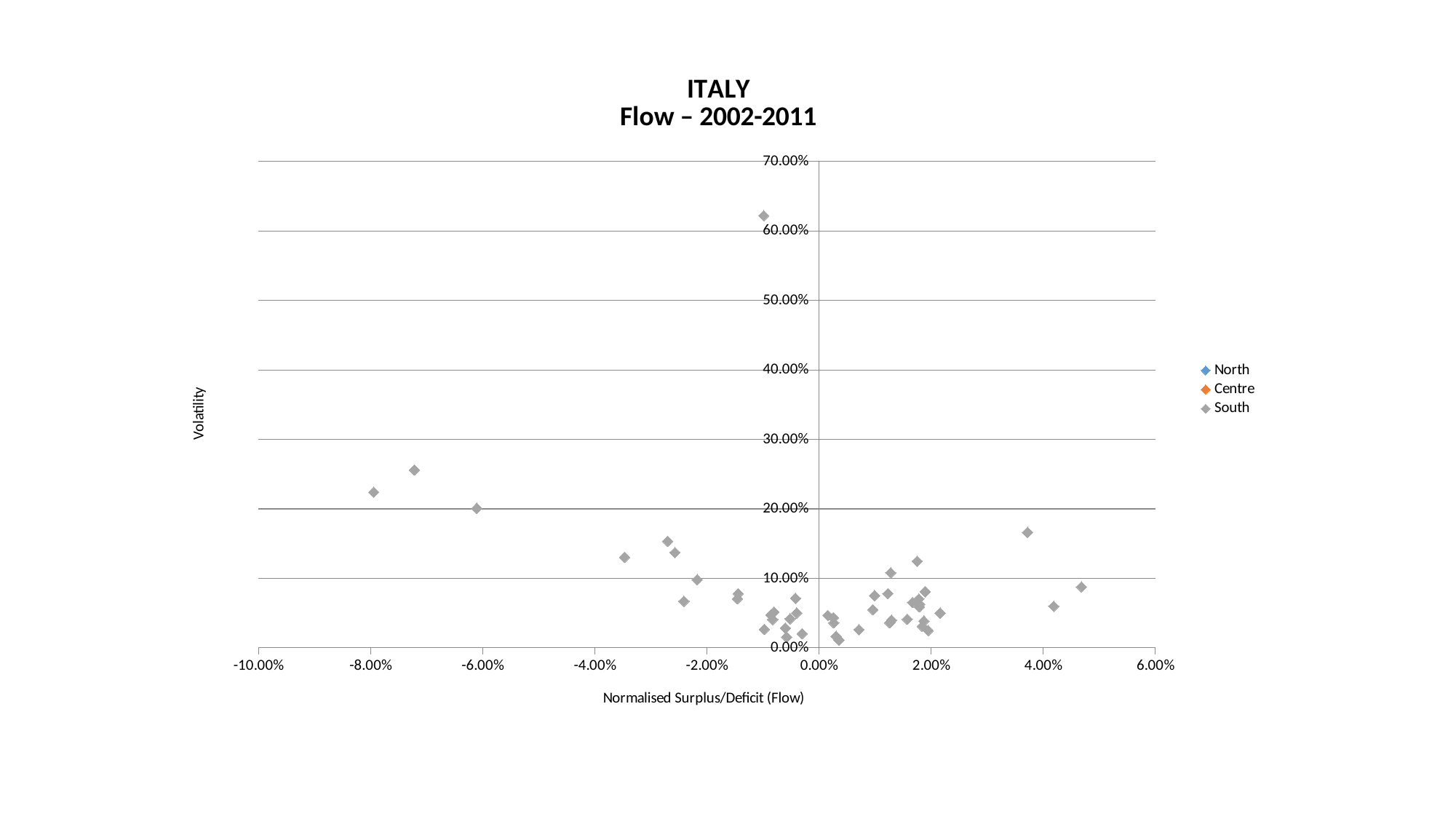
What kind of chart is shown on the slide? Scatter chart What is the title of the chart? ITALY Flow – 2002-2011 What is the label of the horizontal axis? Normalised Surplus/Deficit (Flow) What is the minimum value shown on the horizontal axis? -10.00% Is the volatility of the leftmost plotted point (near -8.00% on the x axis) greater or less than 20.00%? greater Is the volatility of the rightmost plotted point (near 4.70% on the x axis) greater or less than 10.00%? less Is the highest volatility value plotted on the chart greater or less than 60.00%? greater How many series does the legend list? 3